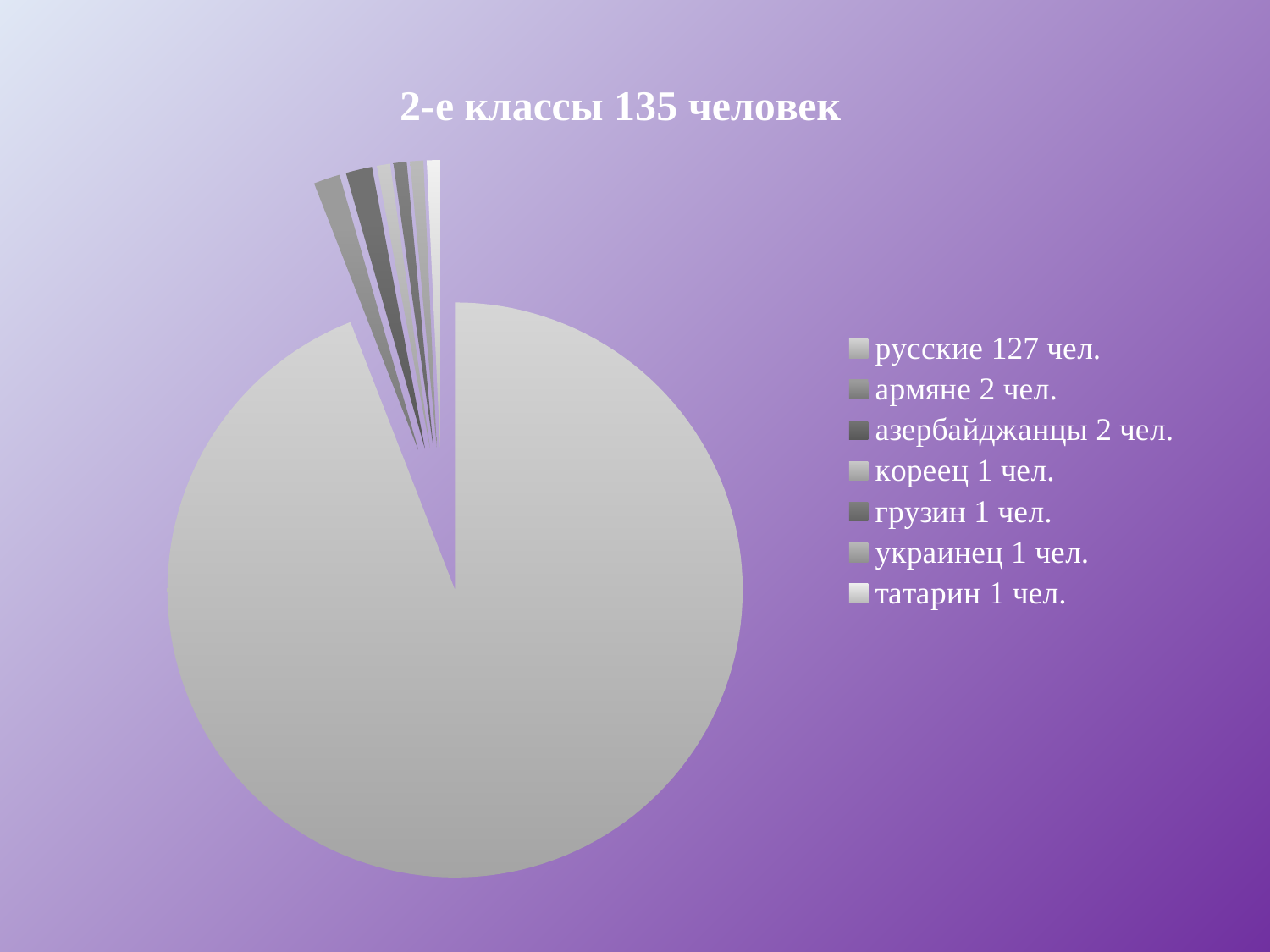
What is the title of the chart? 2-е классы 135 человек Which is larger, the value for армяне or the value for кореец? армяне How many categories does the legend list? 7 How many people are in the русские category? 127 чел. How many people are in the азербайджанцы category? 2 чел. How many people are in the татарин category? 1 чел. How many categories in the legend have exactly 1 чел.? 4 What is the difference between the number of русские and the number of армяне? 125 Which category has the largest slice of the pie? русские How many people are in the армяне category? 2 чел. What kind of chart is shown on the slide? pie chart What is the total number of people represented by the chart, as stated in the title? 135 человек